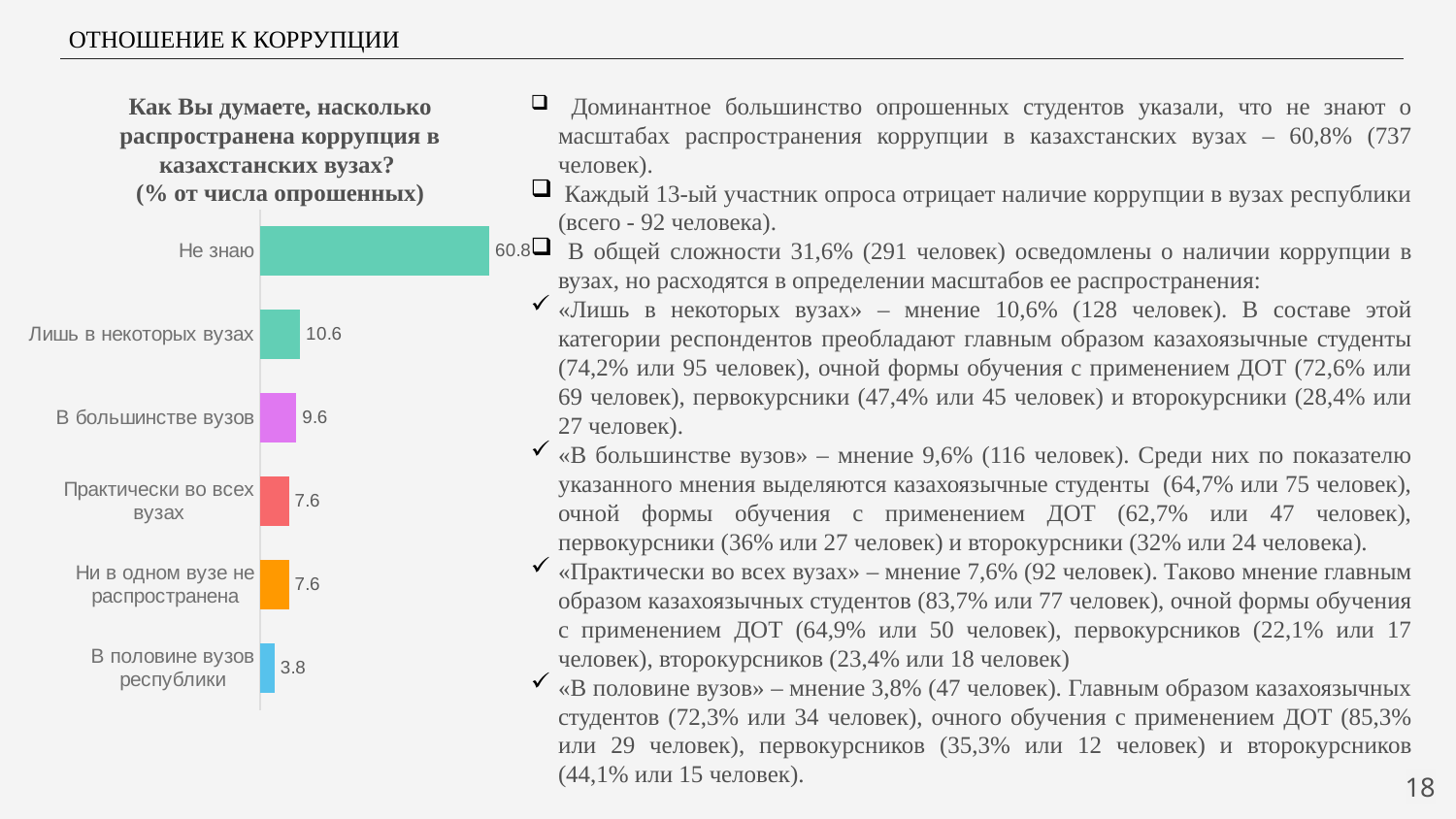
What value is shown for «В большинстве вузов»? 9.6 What value is shown for «Не знаю»? 60.8 What kind of chart is shown on the slide? Bar chart What value is shown for «В половине вузов республики»? 3.8 How many categories are shown in the chart? 6 What is the difference between the values for «В большинстве вузов» and «В половине вузов республики»? 5.8 What value is shown for «Лишь в некоторых вузах»? 10.6 What is the difference between the values for «Не знаю» and «Лишь в некоторых вузах»? 50.2 Which category has the highest value? Не знаю Which category has the lowest value? В половине вузов республики Which is larger: the value for «Лишь в некоторых вузах» or for «В большинстве вузов»? Лишь в некоторых вузах Which two categories share the same value of 7.6? Практически во всех вузах and Ни в одном вузе не распространена